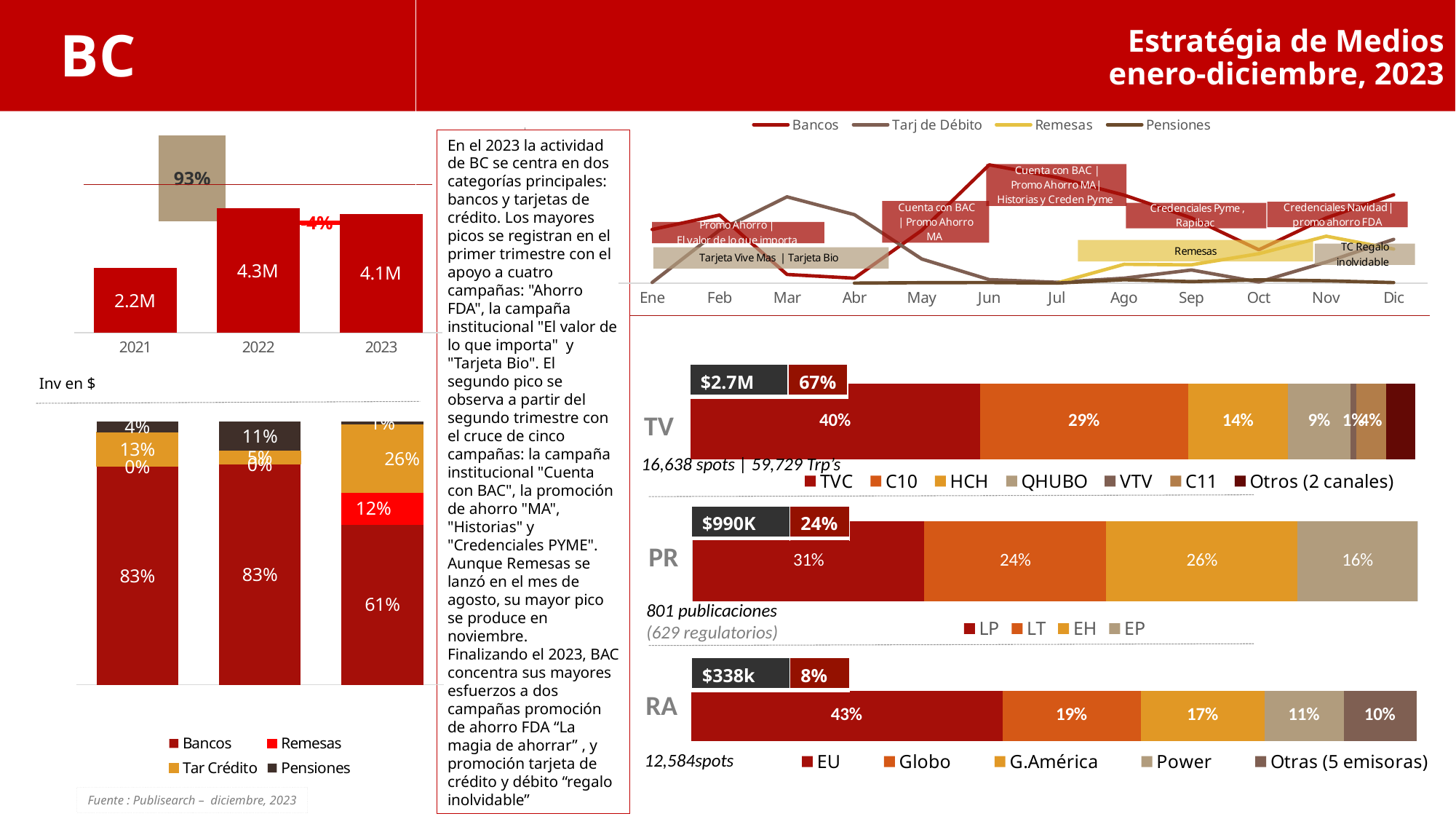
In the line chart at the top right, how many months are shown on the x axis? 12 In the TV bar on the right, what is the share for C10? 29% In the stacked bar chart at the bottom left, what is the difference between the Pensiones share in 2022 and in 2021? 7% In the RA bar on the right, what is the difference between the EU share and the Globo share? 24% In the 'Inv en $' bar chart on the left, what kind of chart is it? bar chart In the 'Inv en $' bar chart on the left, what is the percentage change label shown between 2021 and 2022? 93% In the 'Inv en $' bar chart on the left, what is the value for 2022? 4.3M In the stacked bar chart at the bottom left, what is the share for Tar Crédito in 2023? 26% In the stacked bar chart at the bottom left, what is the share for Bancos in 2023? 61% In the stacked bar chart at the bottom left, how many series does the legend list? 4 In the PR bar on the right, which category has the largest share? LP In the 'Inv en $' bar chart on the left, which year has the lowest investment? 2021